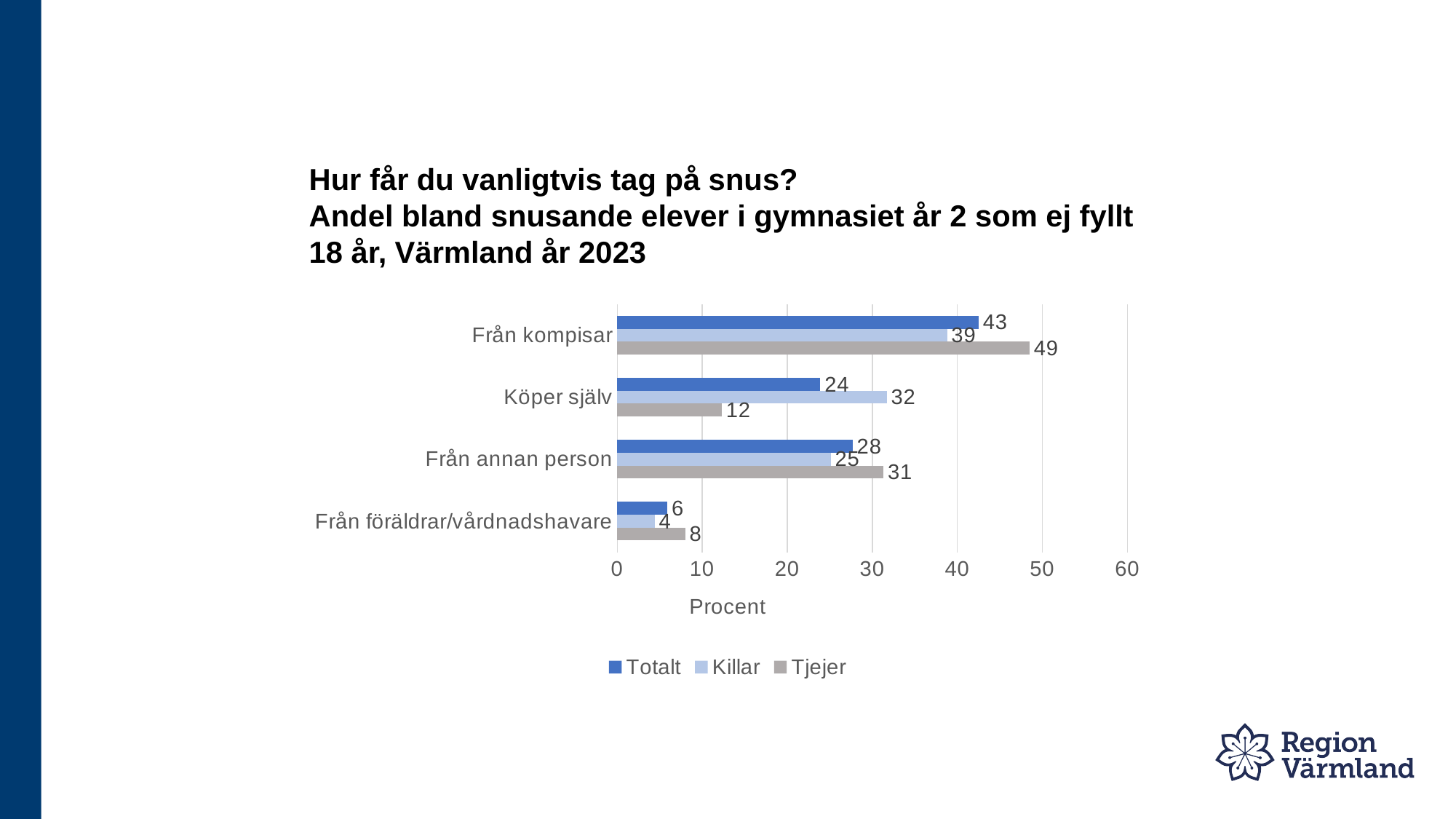
What is the Totalt value for Från kompisar? 43 How many series does the legend list? 3 What kind of chart is shown on the slide? bar chart For Från annan person, which is larger: the Totalt value or the Tjejer value? Tjejer What is the Killar value for Från annan person? 25 Which category has the highest Tjejer value? Från kompisar What is the label of the x axis? Procent What is the Tjejer value for Köper själv? 12 Is the Tjejer value for Från kompisar greater or less than 40? greater How many categories are shown on the y axis? 4 Which category has the lowest Killar value? Från föräldrar/vårdnadshavare What is the difference between the Killar and Tjejer values for Köper själv? 20